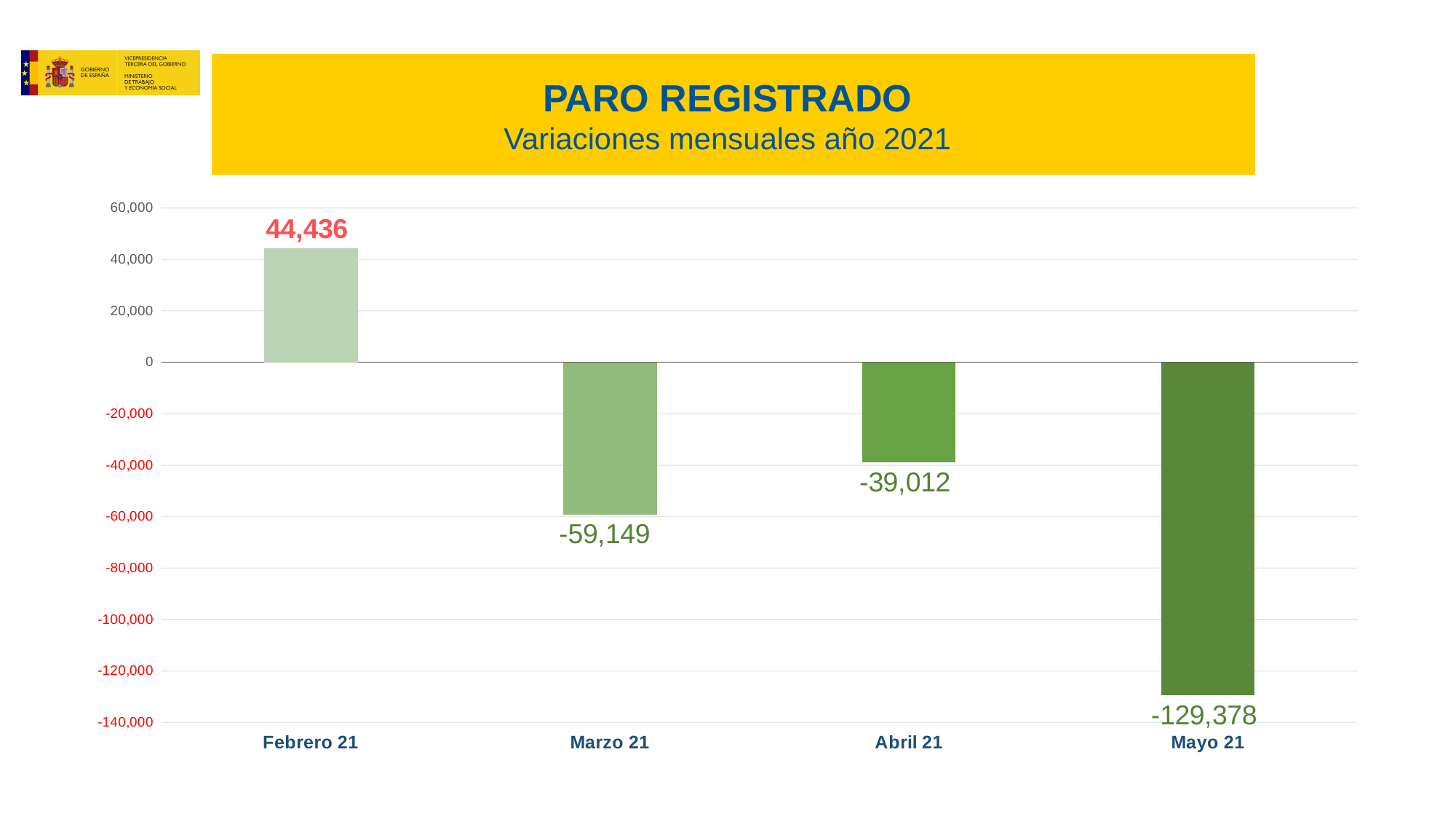
What is the difference between the values for Abril 21 and Marzo 21? 20,137 Which month has the lowest value? Mayo 21 Which month has the highest value? Febrero 21 What is the value for Marzo 21? -59,149 How many months are shown on the chart? 4 What kind of chart is shown on the slide? Bar chart Is the value for Mayo 21 greater or less than -120,000? less What is the value for Mayo 21? -129,378 What is the value for Abril 21? -39,012 What is the value for Febrero 21? 44,436 Which is larger, the value for Marzo 21 or the value for Abril 21? Abril 21 What is the difference between the values for Febrero 21 and Mayo 21? 173,814